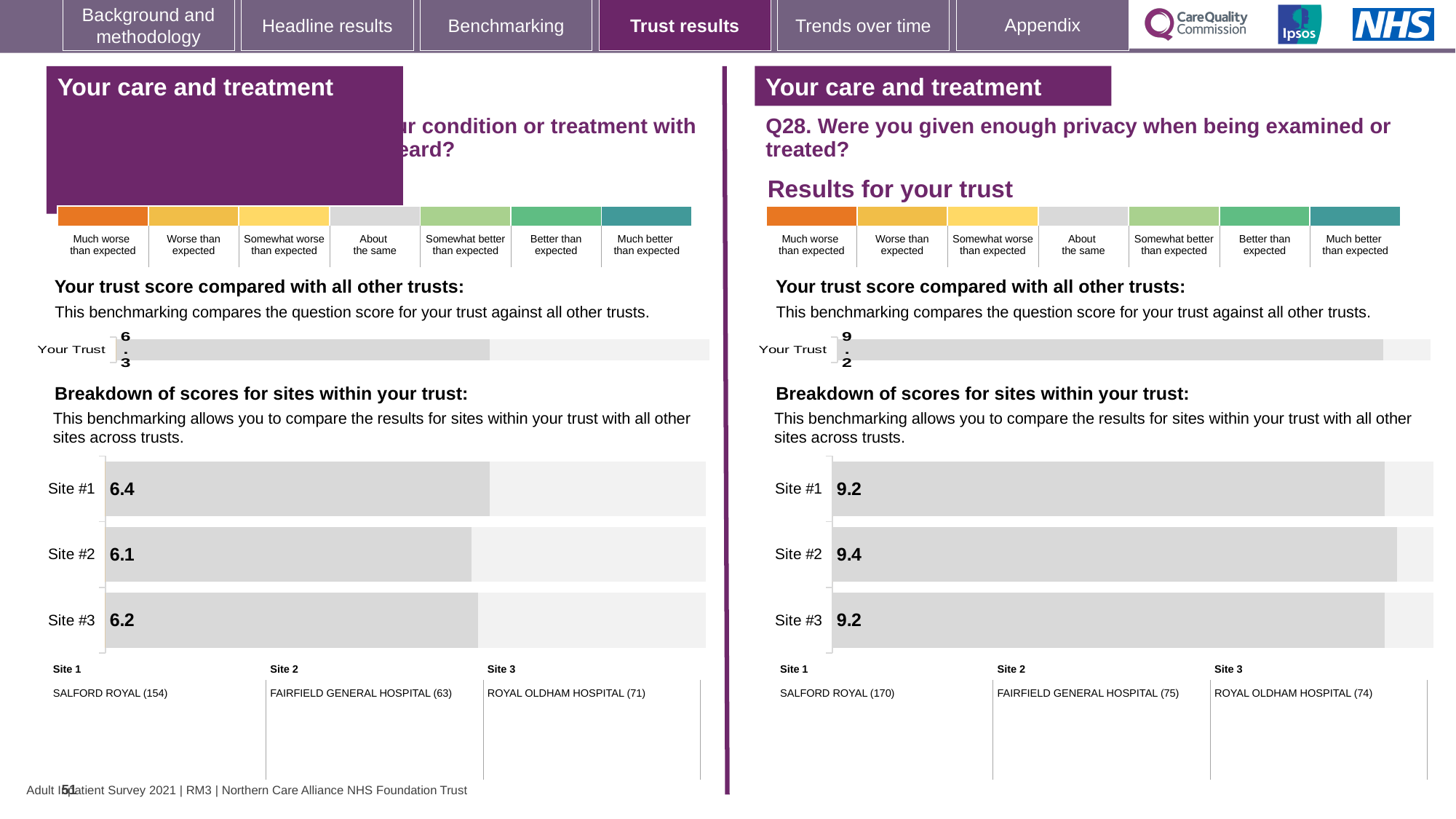
On the left-hand slide half, what is the score for Site #1 in the breakdown of scores for sites within your trust? 6.4 On the right-hand slide half (Q28), what is the score for Site #3 in the breakdown of scores for sites within your trust? 9.2 How many sites are shown in the breakdown of scores chart on the right-hand slide half (Q28)? 3 On the left-hand slide half, what is the 'Your Trust' score shown in the trust score chart? 6.3 On the right-hand slide half (Q28), what is the score for Site #2 in the breakdown of scores for sites within your trust? 9.4 On the left-hand slide half, what is the difference between the Site #1 score and the Site #2 score in the site breakdown chart? 0.3 On the left-hand slide half, which is larger in the site breakdown chart: the score for Site #1 or the score for Site #3? Site #1 On the left-hand slide half, which site has the lowest score in the breakdown of scores for sites within your trust? Site #2 What type of chart is used for the breakdown of scores for sites within your trust on the left-hand slide half? Bar chart On the right-hand slide half (Q28), what is the difference between the Site #2 score and the Site #3 score in the site breakdown chart? 0.2 On the right-hand slide half (Q28), which site has the highest score in the breakdown of scores for sites within your trust? Site #2 On the right-hand slide half (Q28), what is the 'Your Trust' score shown in the trust score chart? 9.2